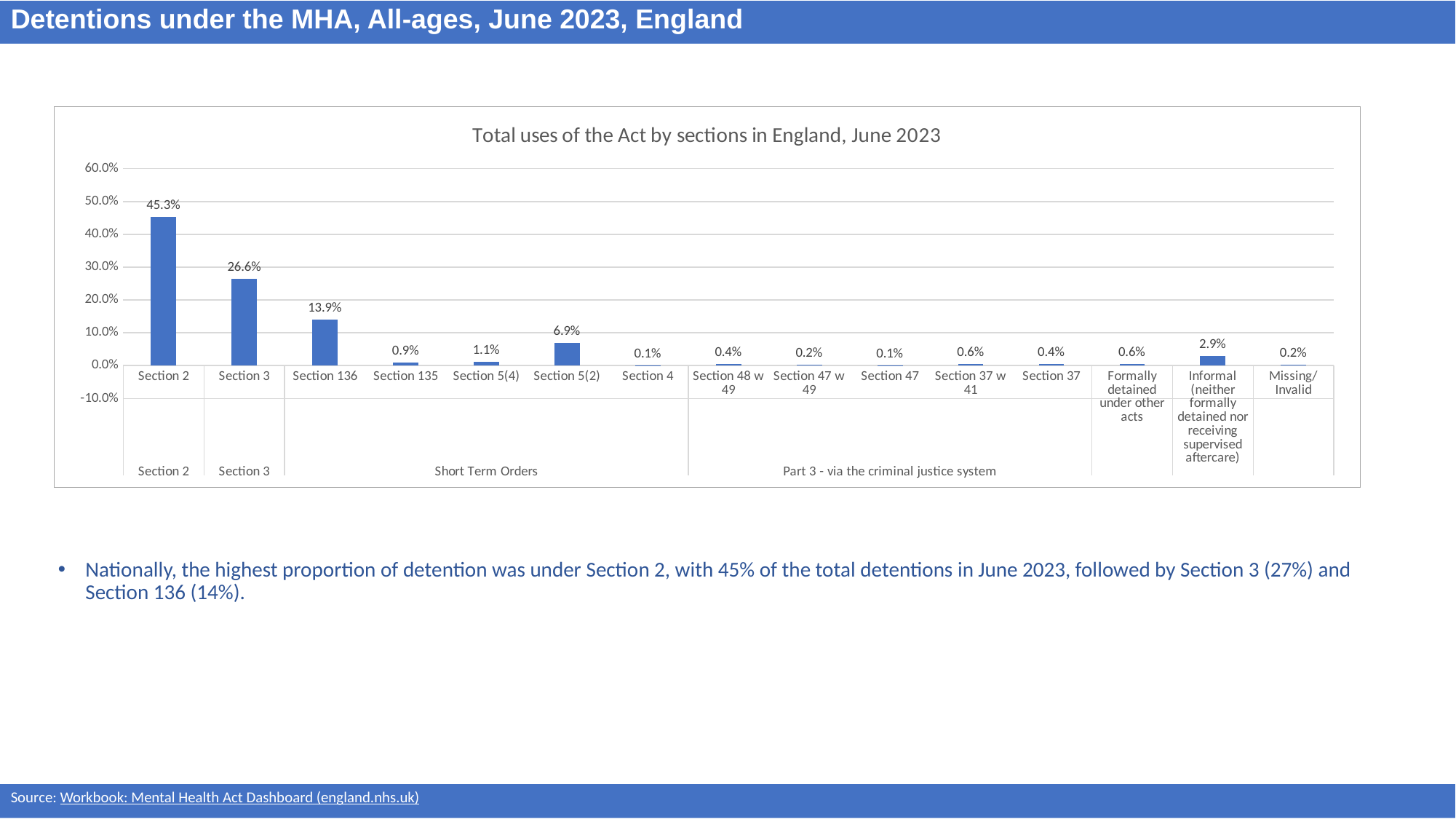
What is the title of the chart? Total uses of the Act by sections in England, June 2023 What is the value for Informal (neither formally detained nor receiving supervised aftercare)? 2.9% What is the difference between the values for Section 2 and Section 3? 18.7% What is the value for Section 5(2)? 6.9% How many categories are shown on the x axis? 15 What is the value for Section 136? 13.9% Which category has the highest value? Section 2 What is the value for Section 2? 45.3% Is the value for Section 3 greater or less than 20.0%? greater Which is larger, the value for Section 5(2) or the value for Section 5(4)? Section 5(2) What is the difference between the values for Section 3 and Section 136? 12.7% What kind of chart is shown on the slide? Bar chart